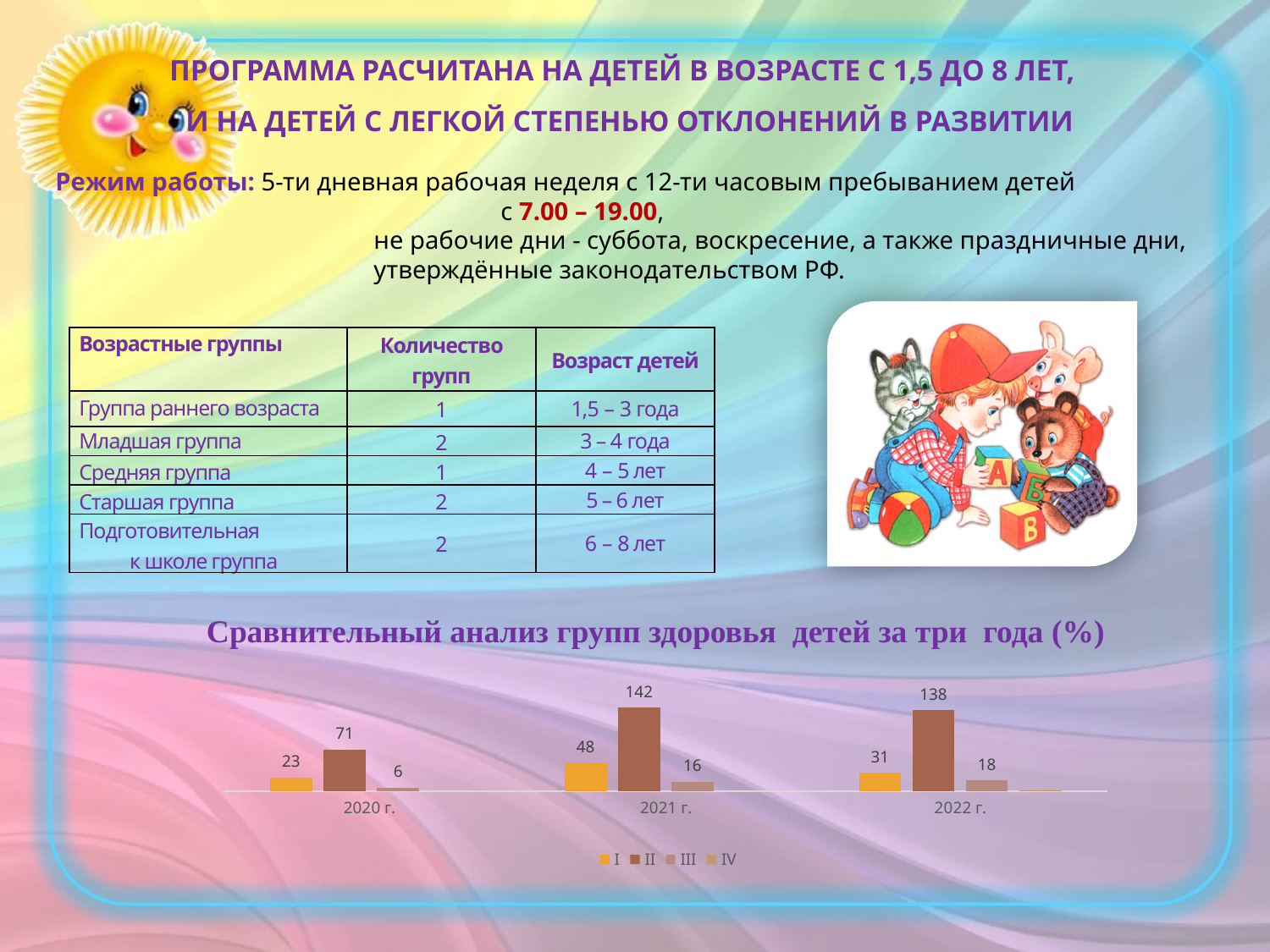
In which year is the value for series III the lowest? 2020 г. What is the value for series II in 2021 г.? 142 What is the value for series III in 2022 г.? 18 How many year categories are shown on the x axis? 3 Which is larger: the series I value in 2021 г. or in 2022 г.? 2021 г. What is the title of the chart? Сравнительный анализ групп здоровья детей за три года (%) What is the value for series II in 2022 г.? 138 What is the value for series I in 2020 г.? 23 What type of chart is shown on the slide? bar chart How many series does the legend list? 4 In which year is the value for series II the highest? 2021 г. What is the difference between the series II values for 2021 г. and 2022 г.? 4